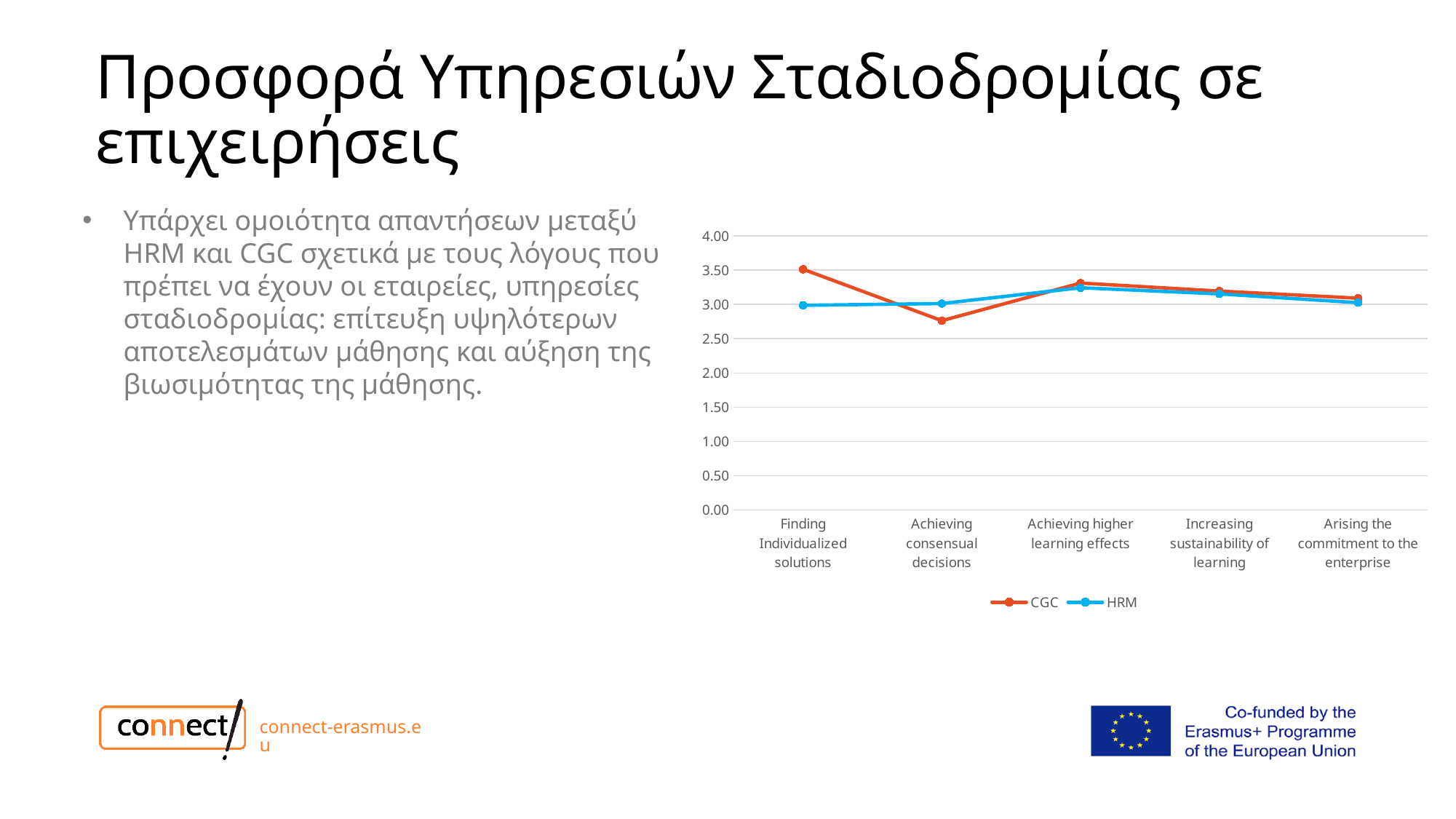
What kind of chart is shown on the slide? line chart Does the CGC line rise or fall from Achieving higher learning effects to Arising the commitment to the enterprise? fall How many categories are shown on the x axis of the chart? 5 For the CGC series, which category has the highest value? Finding Individualized solutions Is the CGC value for Finding Individualized solutions greater or less than 3.00? greater Is the CGC value for Achieving consensual decisions greater or less than 3.00? less For Achieving consensual decisions, which series has the larger value, CGC or HRM? HRM Which series is drawn in blue in the chart? HRM Is the HRM value for Achieving higher learning effects greater or less than 3.00? greater For the CGC series, which category has the lowest value? Achieving consensual decisions How many series does the chart legend list? 2 For Finding Individualized solutions, which series has the larger value, CGC or HRM? CGC